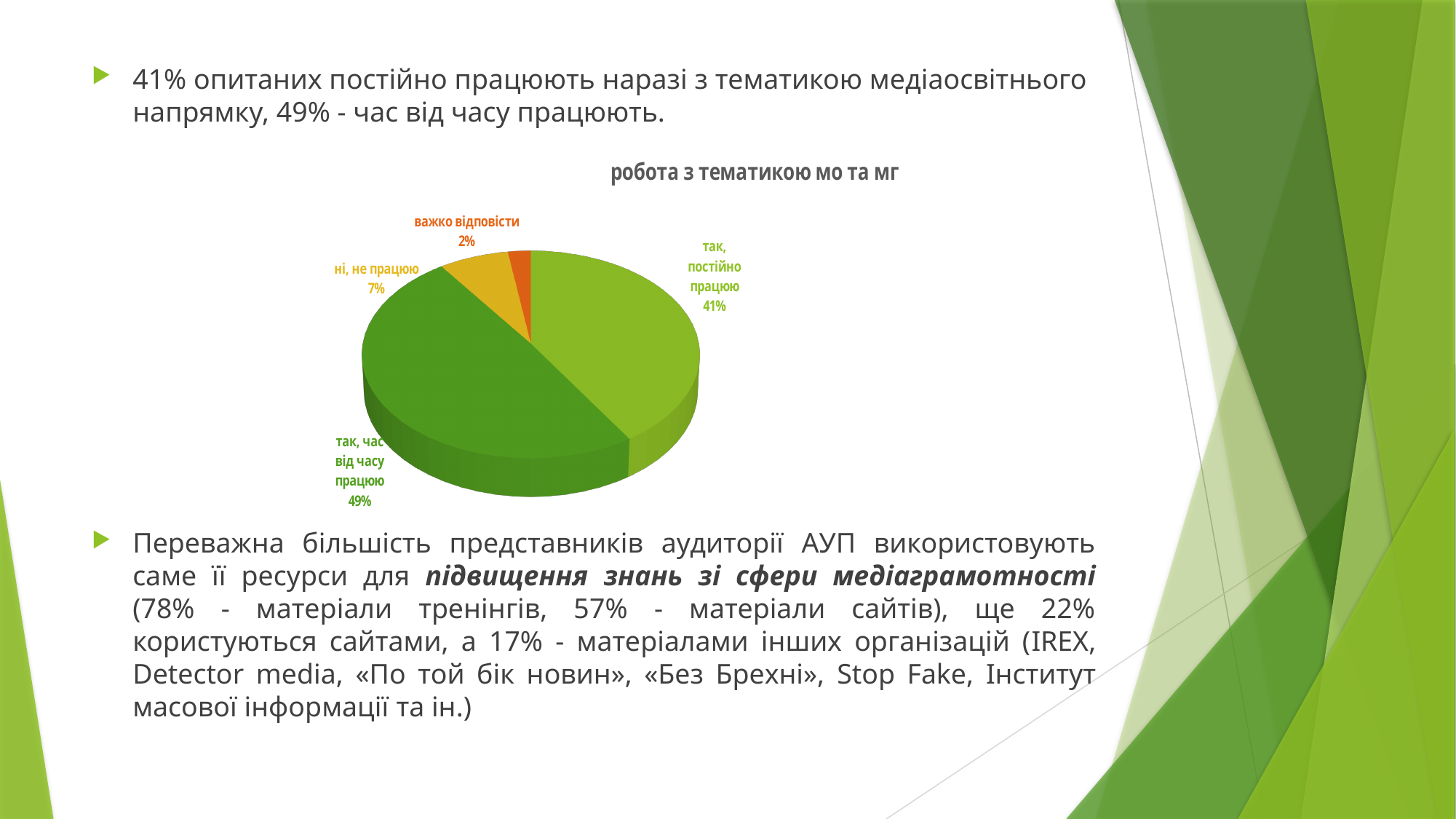
Which slice of the pie chart is the largest? так, час від часу працюю What is the title of the chart? робота з тематикою мо та мг What share of the pie is labelled "ні, не працюю"? 7% What share of the pie is labelled "так, постійно працюю"? 41% Which is larger: the "ні, не працюю" slice or the "важко відповісти" slice? ні, не працюю Which slice of the pie chart is the smallest? важко відповісти What colour is the "важко відповісти" slice? orange How many slices does the pie chart have? 4 What share of the pie is labelled "важко відповісти"? 2% What kind of chart is shown on the slide? pie chart What is the difference in percentage points between the "так, час від часу працюю" slice and the "так, постійно працюю" slice? 8